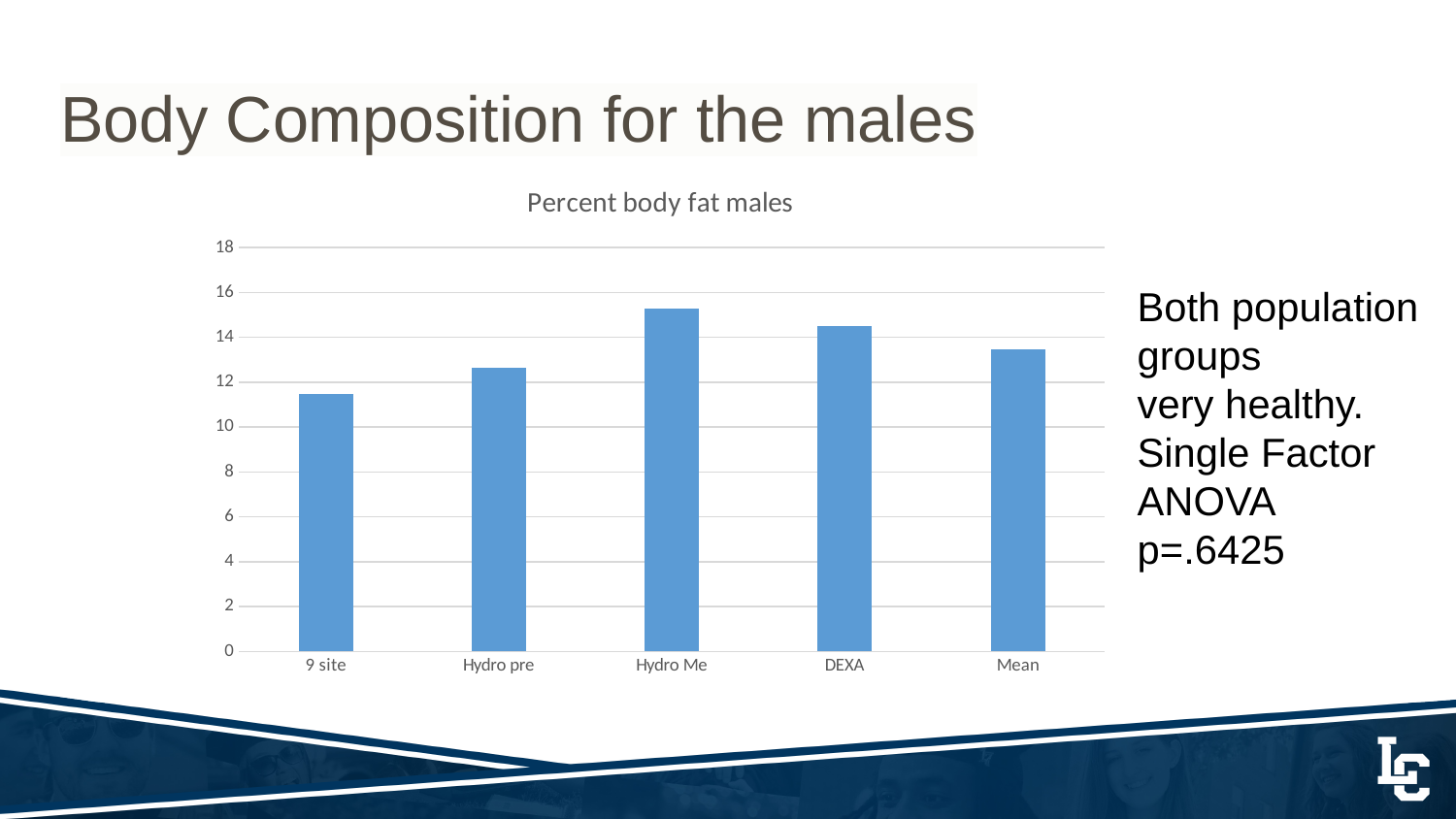
Is the value for 9 site greater or less than 12? less Which category has the lowest value? 9 site Is the value for DEXA greater or less than 16? less Is the value for Hydro Me greater or less than 14? greater What is the title of the chart? Percent body fat males Which is larger, the value for Hydro Me or the value for DEXA? Hydro Me What kind of chart is shown on the slide? bar chart Which category has the highest value? Hydro Me How many categories are plotted in the chart? 5 What is the highest value shown on the vertical axis? 18 Which is larger, the value for 9 site or the value for Hydro pre? Hydro pre